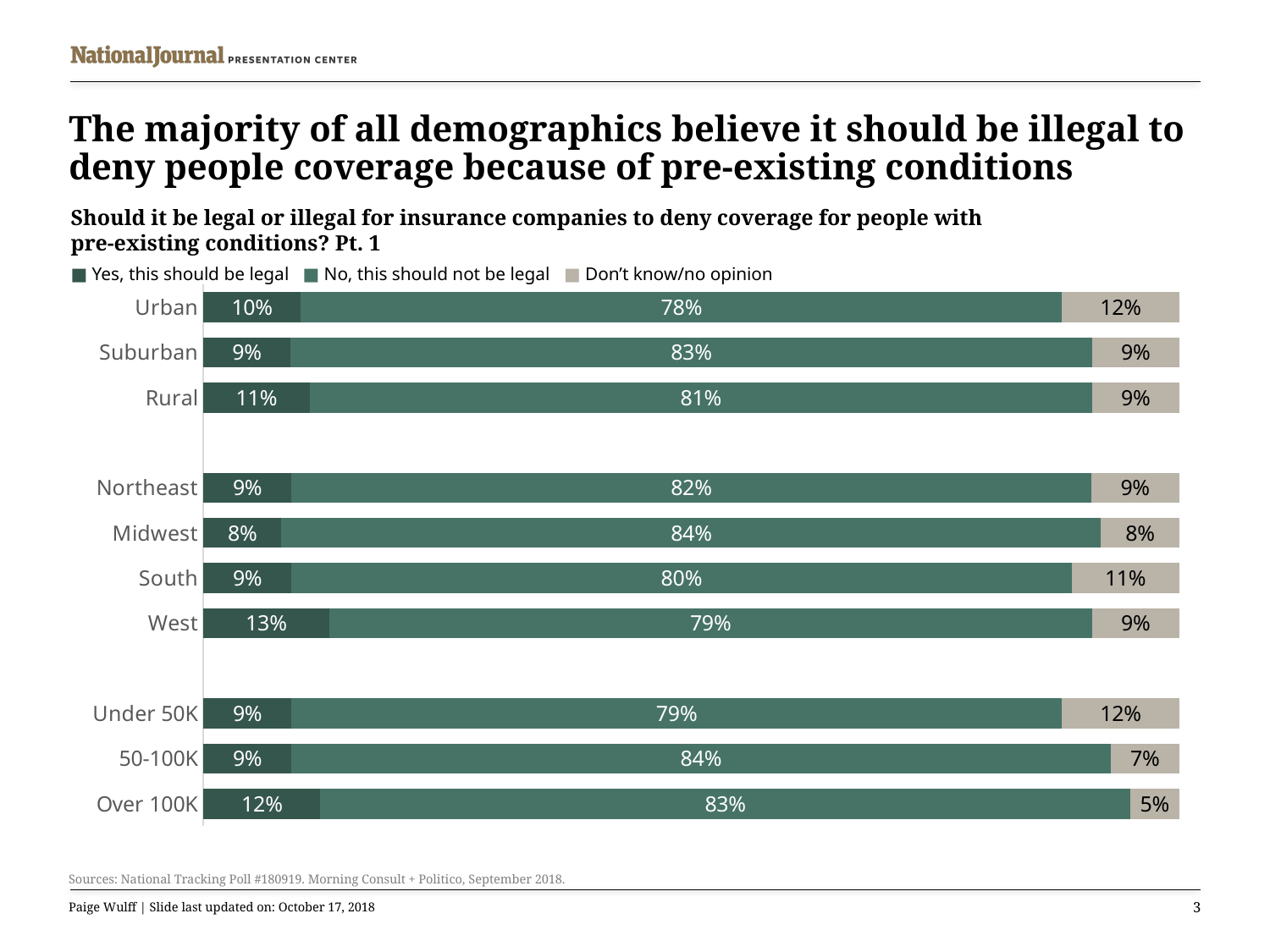
What is the third legend entry in the chart? Don't know/no opinion Which group has a larger "Yes, this should be legal" share, West or Urban? West Which demographic group has the lowest "Don't know/no opinion" share? Over 100K What percentage of Midwest respondents said "Yes, this should be legal"? 8% What is the "Don't know/no opinion" value for the Over 100K group? 5% For Urban respondents, how many percentage points higher is "No, this should not be legal" than "Yes, this should be legal"? 68 percentage points How many series does the legend list? 3 What kind of chart is shown on the slide? Stacked bar chart What percentage of Urban respondents said "No, this should not be legal"? 78% Which demographic group has the highest share saying "Yes, this should be legal"? West What is the total of the three segments in the Urban bar? 100% How many demographic groups are shown in the chart? 10